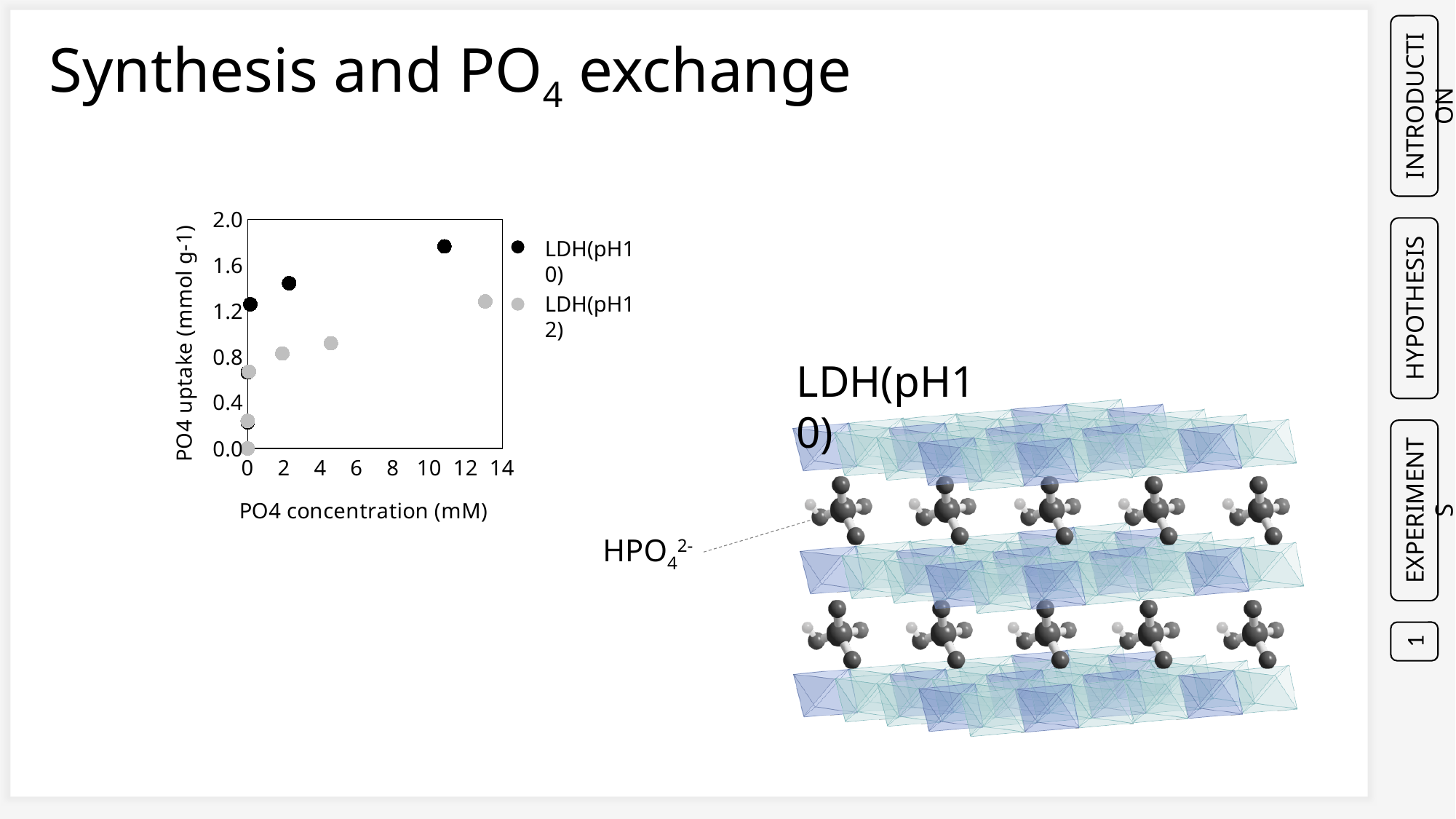
How many series does the chart legend list? 2 What kind of chart is shown on the slide? scatter chart Is the PO4 uptake of the highest LDH(pH12) point (near 13 mM) greater or less than 1.6? less Does PO4 uptake for LDH(pH12) rise or fall as PO4 concentration increases? rise Which series reaches the highest PO4 uptake on the chart? LDH(pH10) Is the PO4 uptake of the highest LDH(pH10) point (near 11 mM) greater or less than 1.6? greater Does PO4 uptake for LDH(pH10) rise or fall as PO4 concentration increases? rise Is the PO4 uptake of the LDH(pH12) point near 4.5 mM greater or less than 1.2? less What is the x-axis title of the chart? PO4 concentration (mM) At a PO4 concentration of about 2 mM, which series shows the higher PO4 uptake, LDH(pH10) or LDH(pH12)? LDH(pH10) What are the two series named in the chart legend? LDH(pH10) and LDH(pH12)